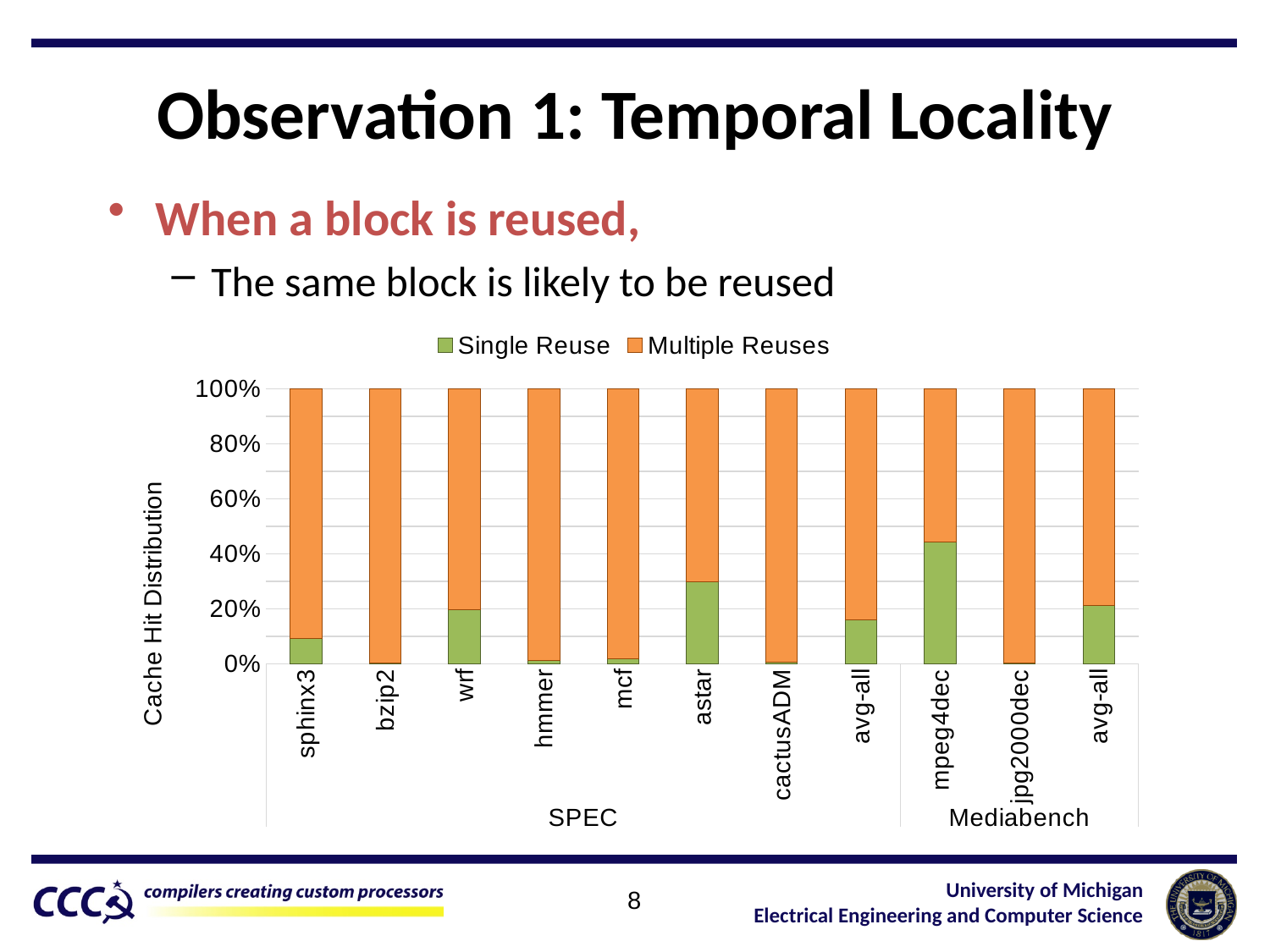
Which has a larger Multiple Reuses share, bzip2 or mpeg4dec? bzip2 Which colour represents Multiple Reuses in the legend? orange What is the total height of each stacked bar? 100% Which benchmark has the highest Single Reuse share? mpeg4dec Is the Single Reuse value for mpeg4dec greater or less than 40%? greater Which has a larger Single Reuse share, astar or sphinx3? astar Is the Single Reuse value for sphinx3 greater or less than 20%? less How many benchmark categories are plotted along the x axis? 11 Is the Single Reuse value for astar greater or less than 20%? greater What kind of chart is shown on the slide? stacked bar chart How many series does the legend list? 2 What is the label on the y axis? Cache Hit Distribution